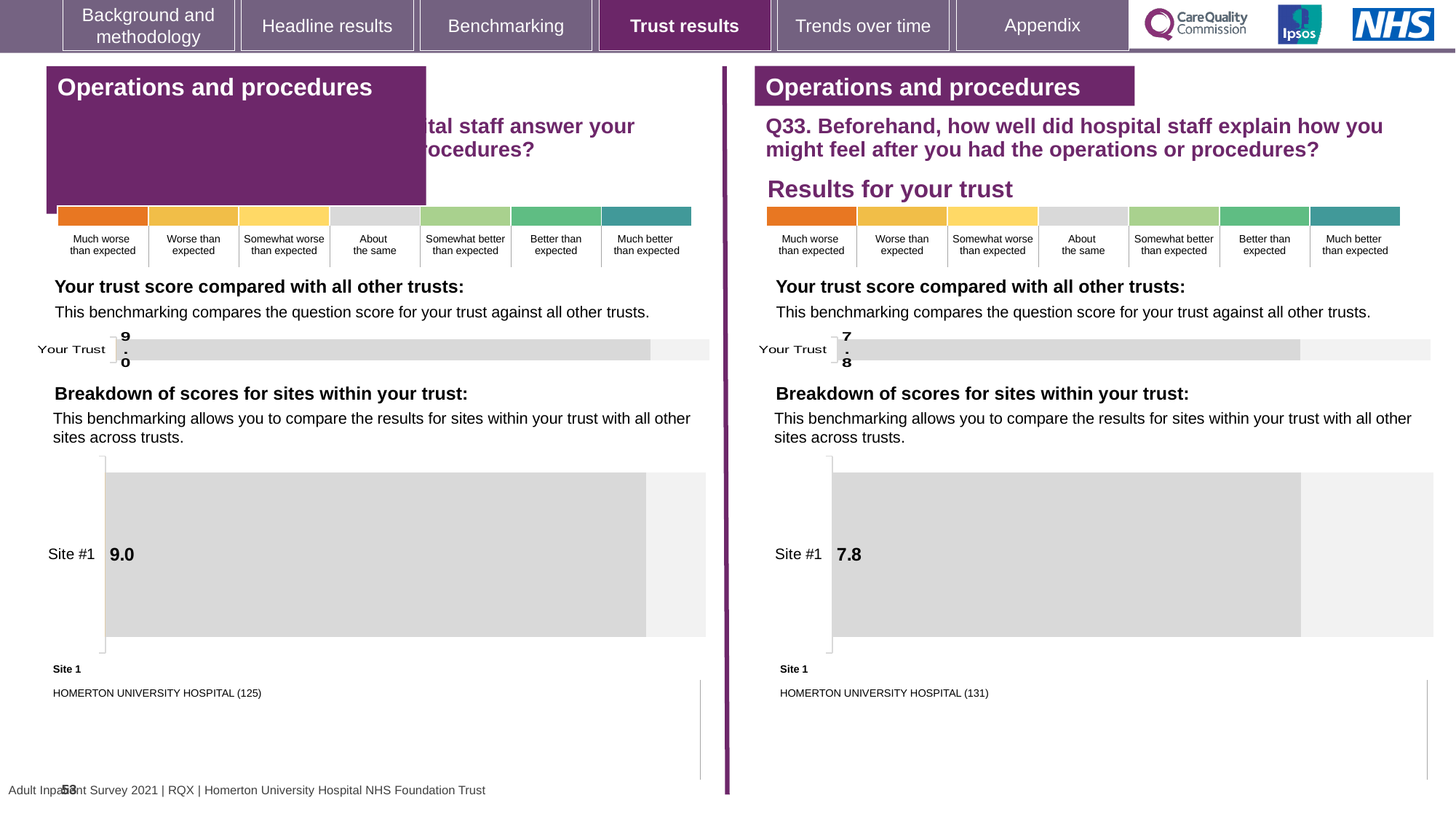
Which hospital is listed as Site 1 below the left breakdown chart? HOMERTON UNIVERSITY HOSPITAL (125) How many sites are shown in the left 'Breakdown of scores for sites within your trust' chart? 1 In the right 'Breakdown of scores for sites within your trust' chart (Q33), what is the score for Site #1? 7.8 Which hospital is listed as Site 1 below the right breakdown chart (Q33)? HOMERTON UNIVERSITY HOSPITAL (131) On the left half of the slide, what is the score shown for Your Trust in the 'Your trust score compared with all other trusts' chart? 9.0 On the right half of the slide (Q33), what is the score shown for Your Trust in the 'Your trust score compared with all other trusts' chart? 7.8 Which is larger: the Your Trust score on the left half of the slide or the Your Trust score on the right half (Q33)? Left half (9.0) What is the difference between the Site #1 score in the left breakdown chart and the Site #1 score in the right breakdown chart (Q33)? 1.2 What kind of chart is used to show the Site #1 score in the right breakdown chart (Q33)? Bar chart In the left 'Breakdown of scores for sites within your trust' chart, what is the score for Site #1? 9.0 Is the Your Trust score on the right half of the slide (Q33) the same as the Site #1 score in the right breakdown chart? Yes, both are 7.8 How many sites are shown in the right 'Breakdown of scores for sites within your trust' chart (Q33)? 1